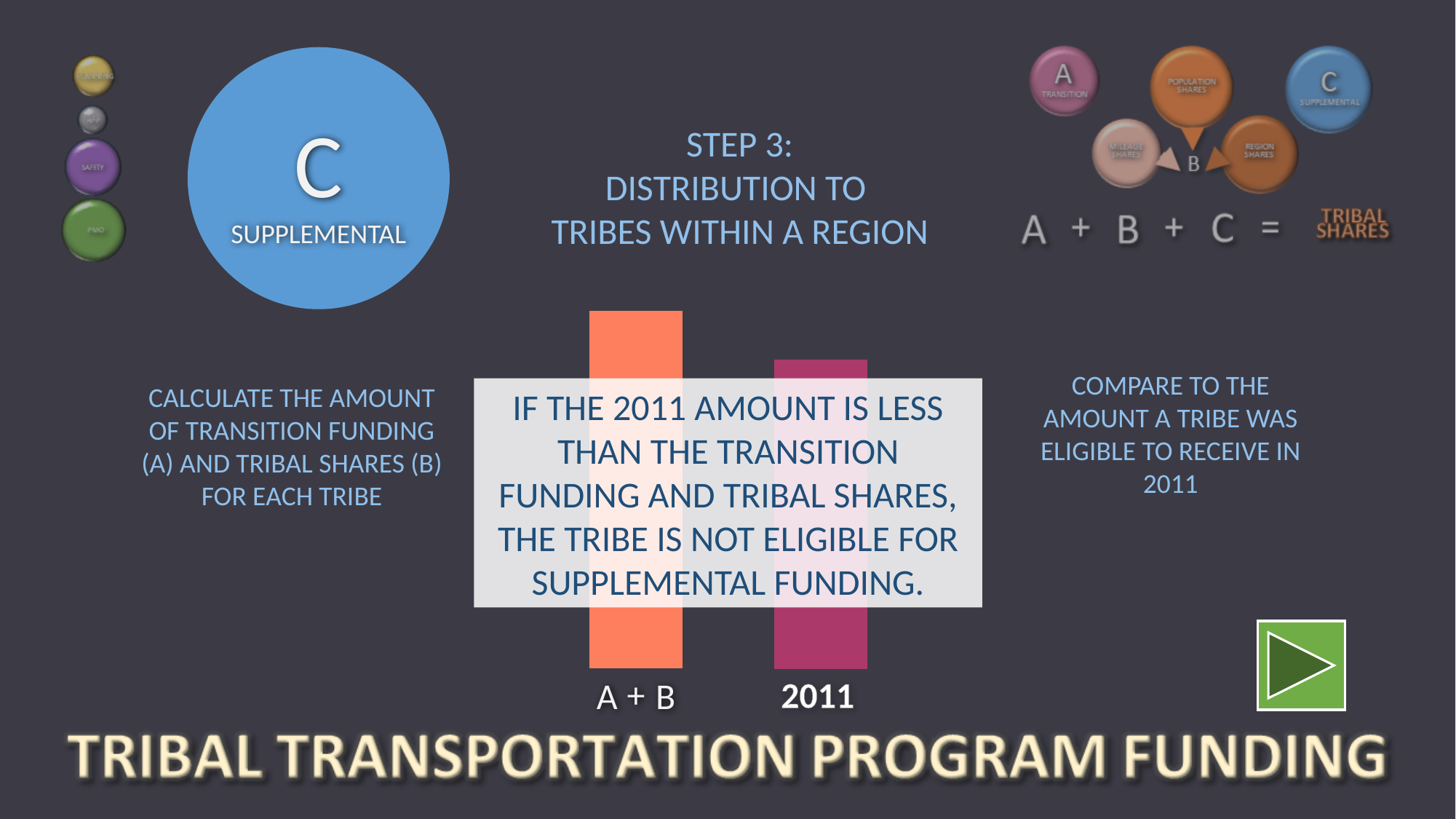
What colour is the 2011 bar? magenta What are the labels of the two bars, from left to right? A + B, 2011 Which bar is taller, A + B or 2011? A + B Is the 2011 bar shorter or taller than the A + B bar? shorter Which category has the lowest bar? 2011 Which category has the highest bar? A + B What kind of chart is shown in the centre of the slide? bar chart How many bars does the chart show? 2 What colour is the A + B bar? orange